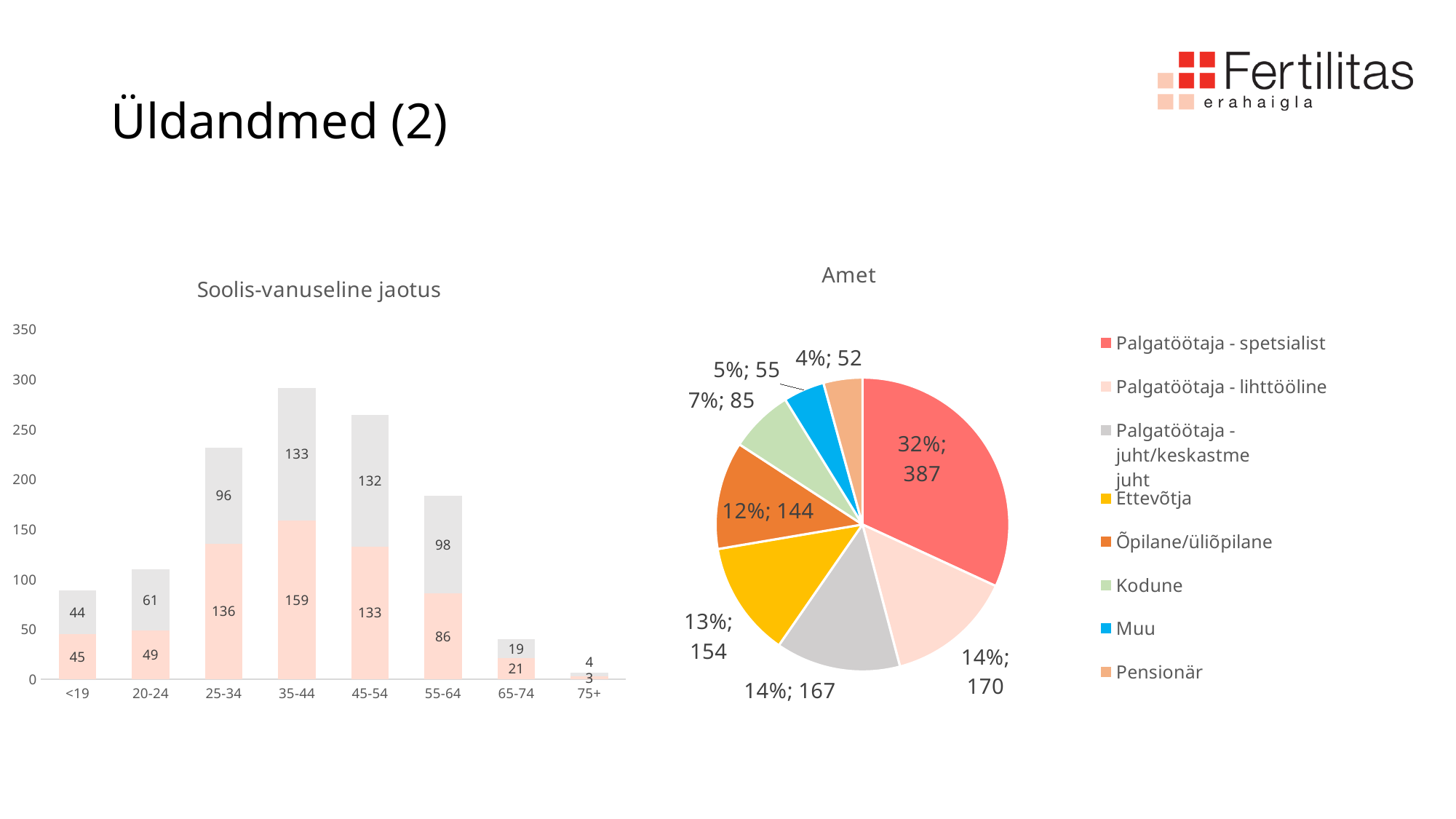
In the 'Soolis-vanuseline jaotus' chart, is the total stacked bar for 45-54 greater or less than 250? greater How many entries does the legend of the 'Amet' pie chart list? 8 In the 'Soolis-vanuseline jaotus' chart, what is the value of the lower (pink) segment for the 35-44 age group? 159 What kind of chart is 'Soolis-vanuseline jaotus'? Stacked bar chart In the 'Soolis-vanuseline jaotus' chart, what is the total of the stacked bar for the 25-34 age group? 232 In the 'Soolis-vanuseline jaotus' chart, which age group has the tallest stacked bar? 35-44 In the 'Soolis-vanuseline jaotus' chart, which age group has the shortest stacked bar? 75+ In the 'Soolis-vanuseline jaotus' chart, how many age groups are shown on the x axis? 8 In the 'Amet' pie chart, what is the value shown for 'Ettevõtja'? 154 In the 'Amet' pie chart, what share does 'Palgatöötaja - spetsialist' have? 32% In the 'Soolis-vanuseline jaotus' chart, what is the difference between the upper (grey) segment values for 20-24 and <19? 17 In the 'Soolis-vanuseline jaotus' chart, what is the value of the upper (grey) segment for the 55-64 age group? 98